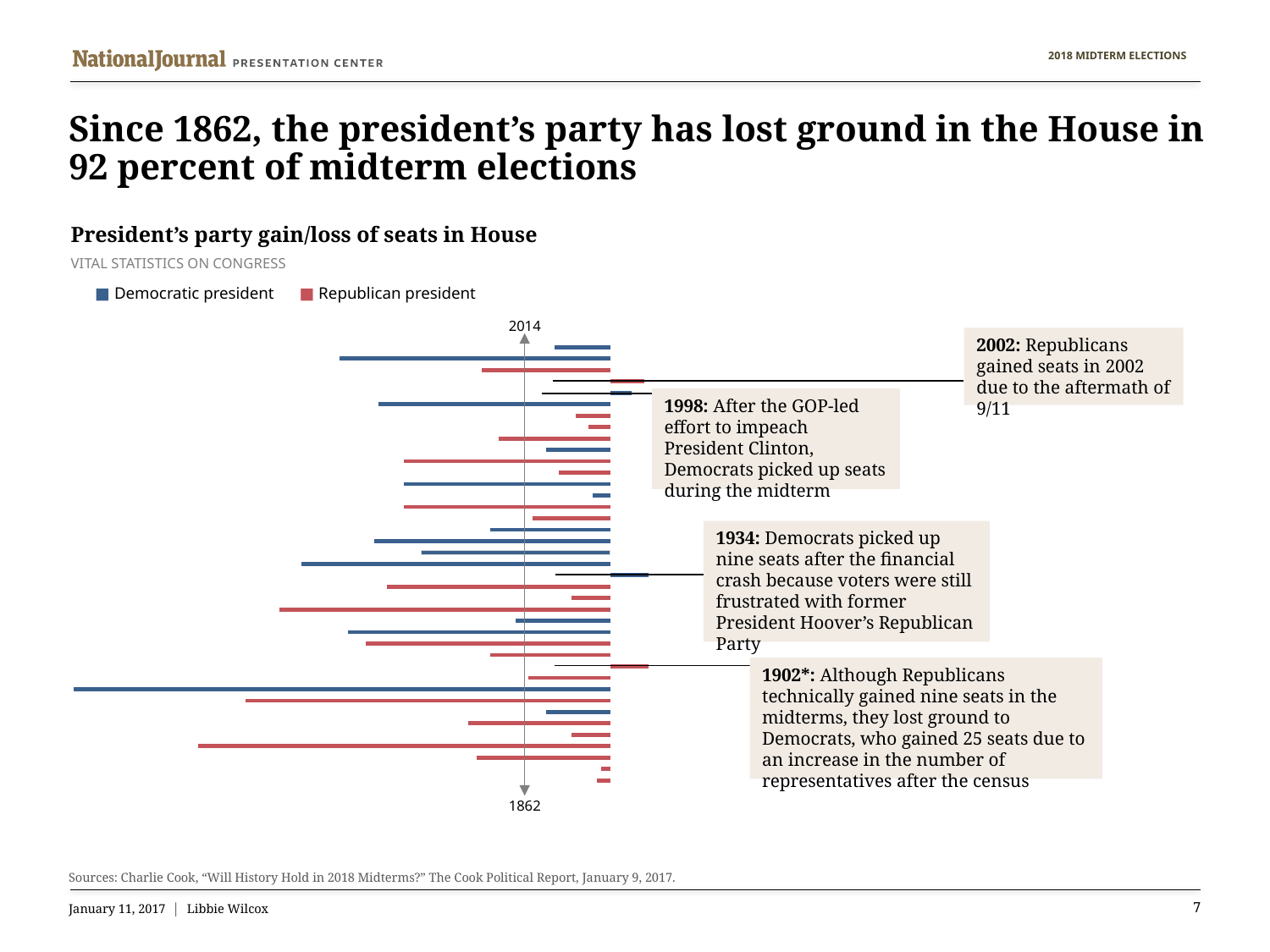
Do most of the bars in the chart extend to the left or to the right of the vertical axis? Left According to the annotation, in which year did Republicans gain seats due to the aftermath of 9/11? 2002 Does the longest bar in the chart belong to the Democratic president series or the Republican president series? Democratic president What are the two series named in the legend? Democratic president and Republican president According to the annotation, how many seats did Democrats pick up in the 1934 midterm? nine What kind of chart is shown on the slide? Bar chart How many series does the legend list? 2 According to the annotation, how many seats did Democrats gain in 1902 due to the increase in the number of representatives? 25 What is the title of the chart? President's party gain/loss of seats in House Which year is labelled at the bottom of the vertical axis? 1862 Which year is labelled at the top of the vertical axis? 2014